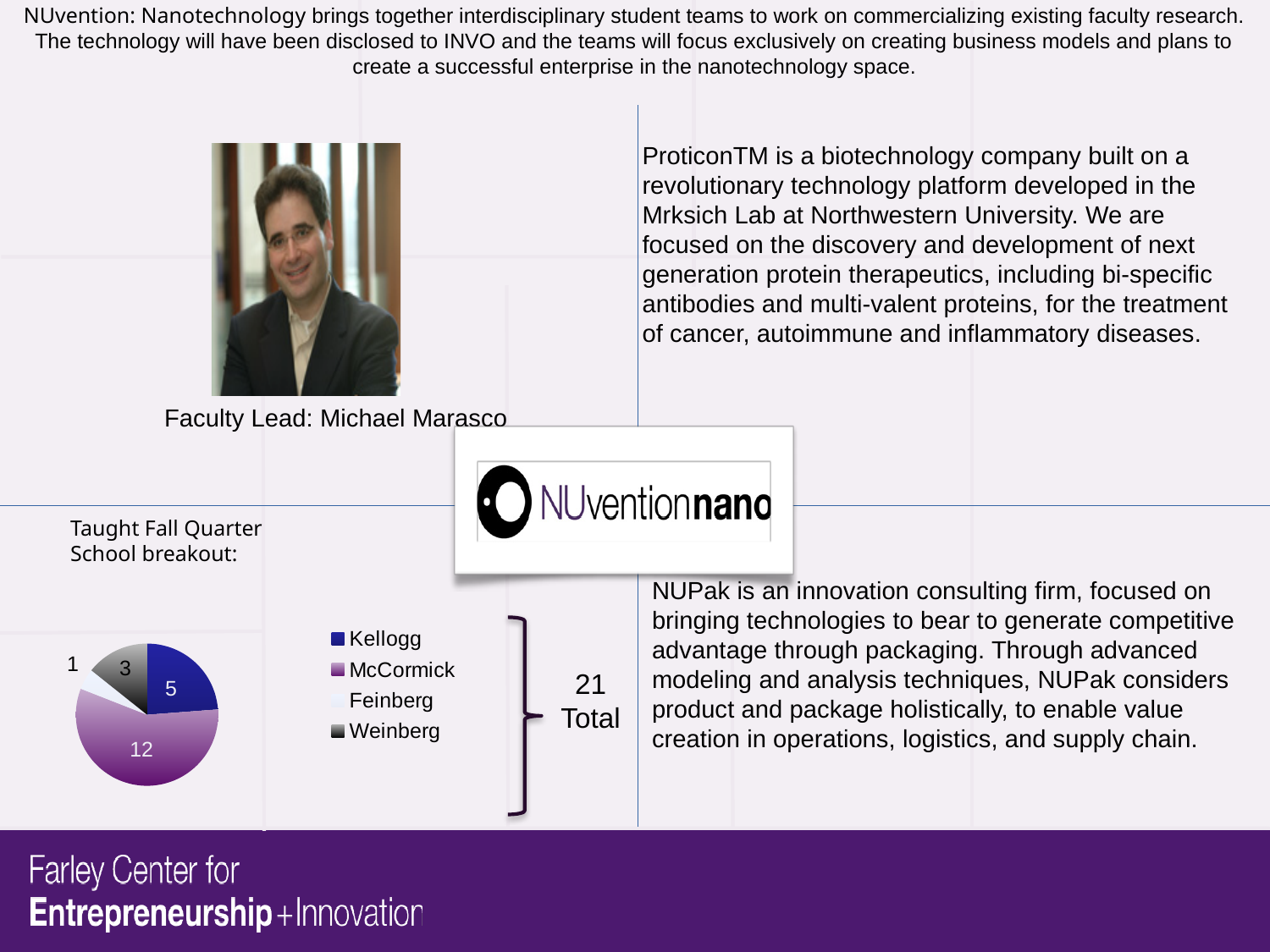
What is the value for Feinberg in the pie chart? 1 Which school has the smallest slice in the pie chart? Feinberg What is the value for Weinberg in the pie chart? 3 Which school has the largest slice in the pie chart? McCormick What is the difference between the McCormick and Kellogg values in the pie chart? 7 How many entries does the legend of the pie chart list? 4 What is the value for McCormick in the pie chart? 12 What is the value for Kellogg in the pie chart? 5 Which is larger in the pie chart, Kellogg or Weinberg? Kellogg How many slices does the pie chart have? 4 What type of chart is shown on the slide? pie chart What total is shown next to the pie chart's legend? 21 Total